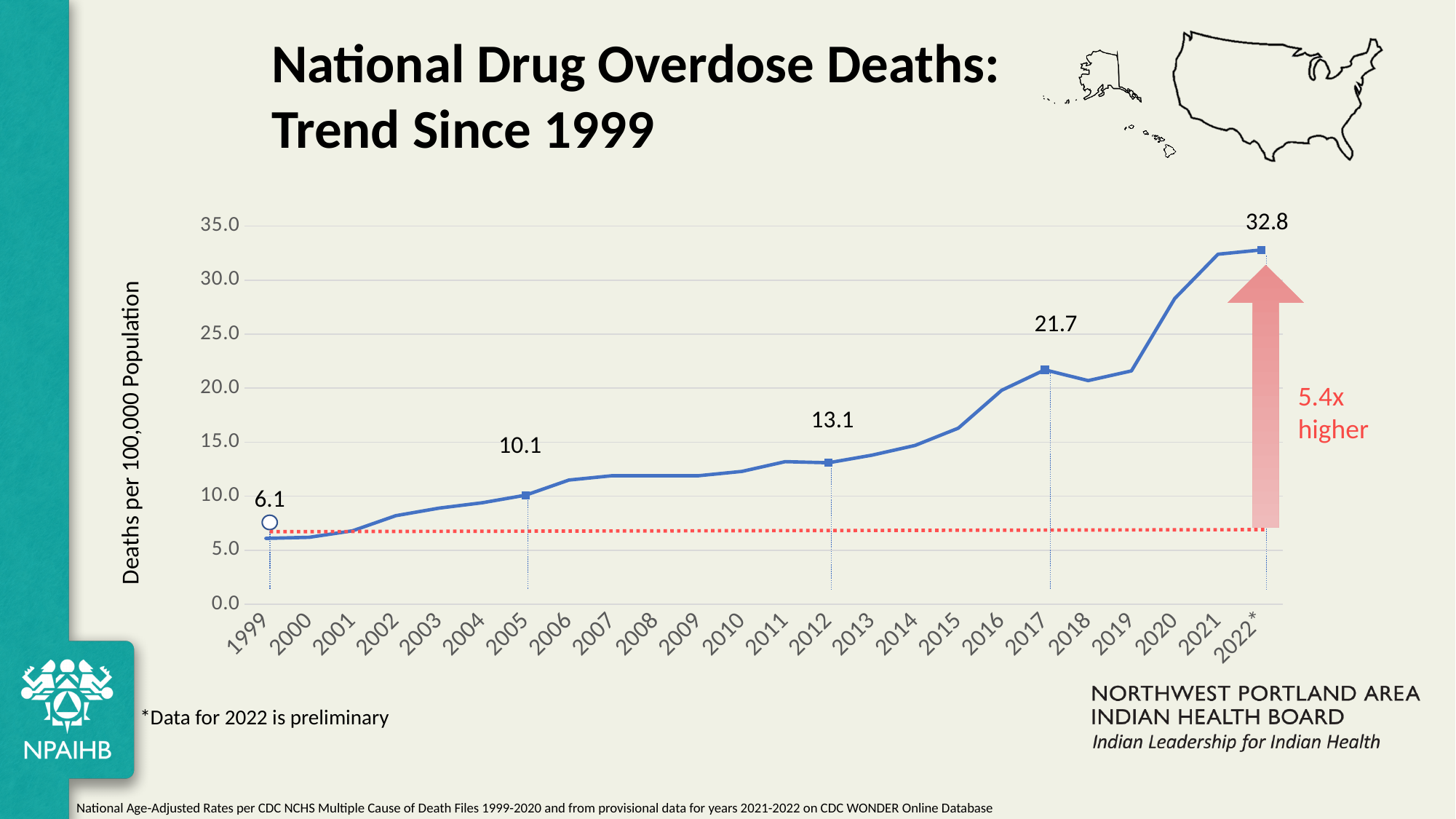
Overall, do the values rise or fall from 1999 to 2022? Rise What is the death rate per 100,000 population labeled for 2017? 21.7 What is the death rate per 100,000 population labeled for 2022*? 32.8 What is the difference between the 2017 rate and the 2012 rate? 8.6 Is the value for 2015 greater or less than 15.0? greater Which year has the highest death rate on the chart? 2022* What type of chart is shown on the slide? Line chart What is the death rate per 100,000 population labeled for 2012? 13.1 What is the death rate per 100,000 population labeled for 2005? 10.1 What is the difference between the 2022* rate and the 1999 rate? 26.7 What is the national drug overdose death rate per 100,000 population in 1999? 6.1 What is the label on the y-axis of the chart? Deaths per 100,000 Population